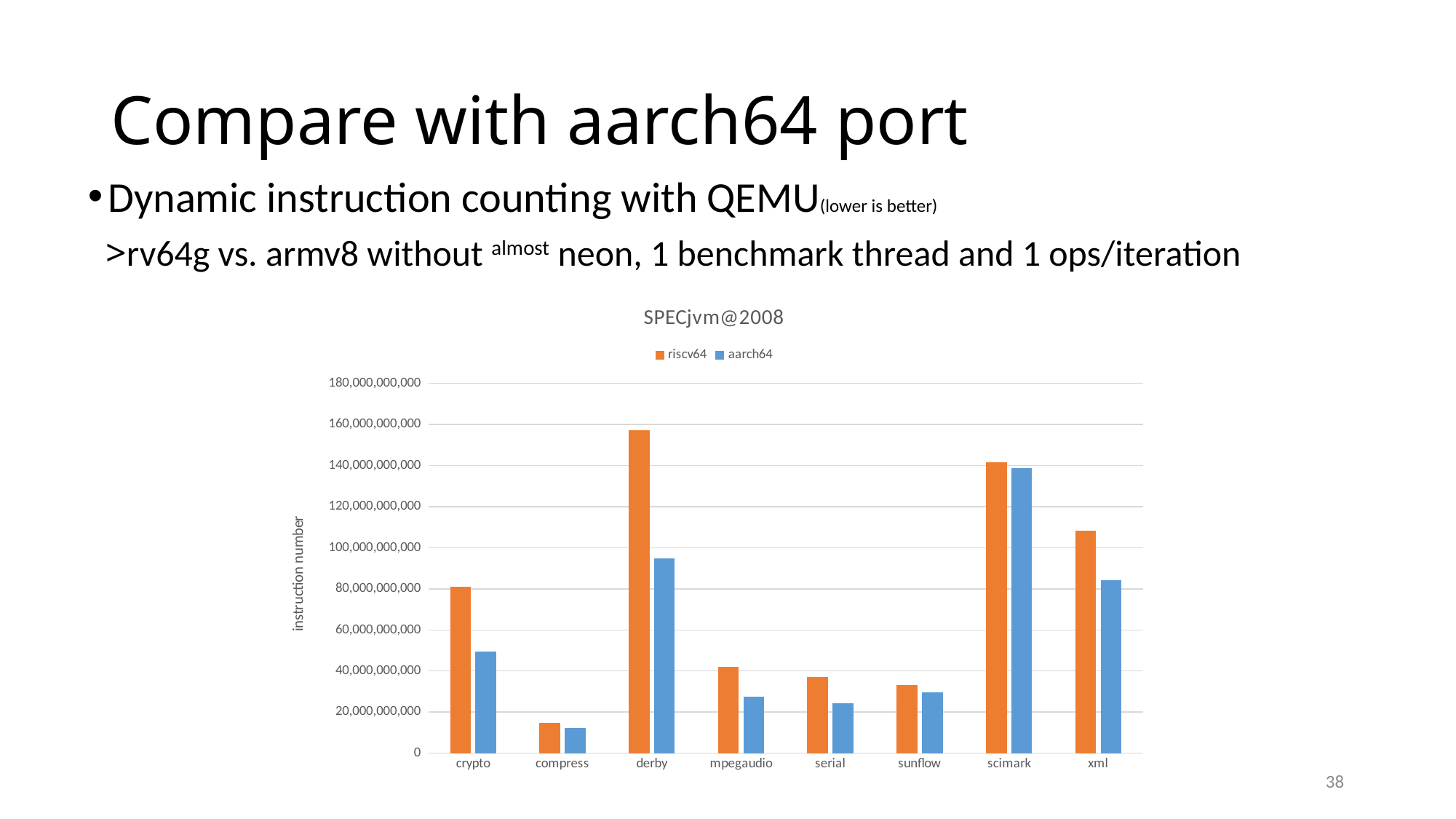
How many benchmark categories are shown on the x axis? 8 Is the aarch64 value for crypto greater or less than 60,000,000,000? less Which benchmark has the lowest riscv64 instruction number? compress What kind of chart is shown on the slide? bar chart What is the title of the chart? SPECjvm@2008 How many series does the legend list? 2 Which benchmark has the lowest aarch64 instruction number? compress For derby, which series has the larger instruction number, riscv64 or aarch64? riscv64 Is the riscv64 value for derby greater or less than 140,000,000,000? greater Is the riscv64 value for xml greater or less than 100,000,000,000? greater Which benchmark has the highest riscv64 instruction number? derby Which benchmark has the highest aarch64 instruction number? scimark